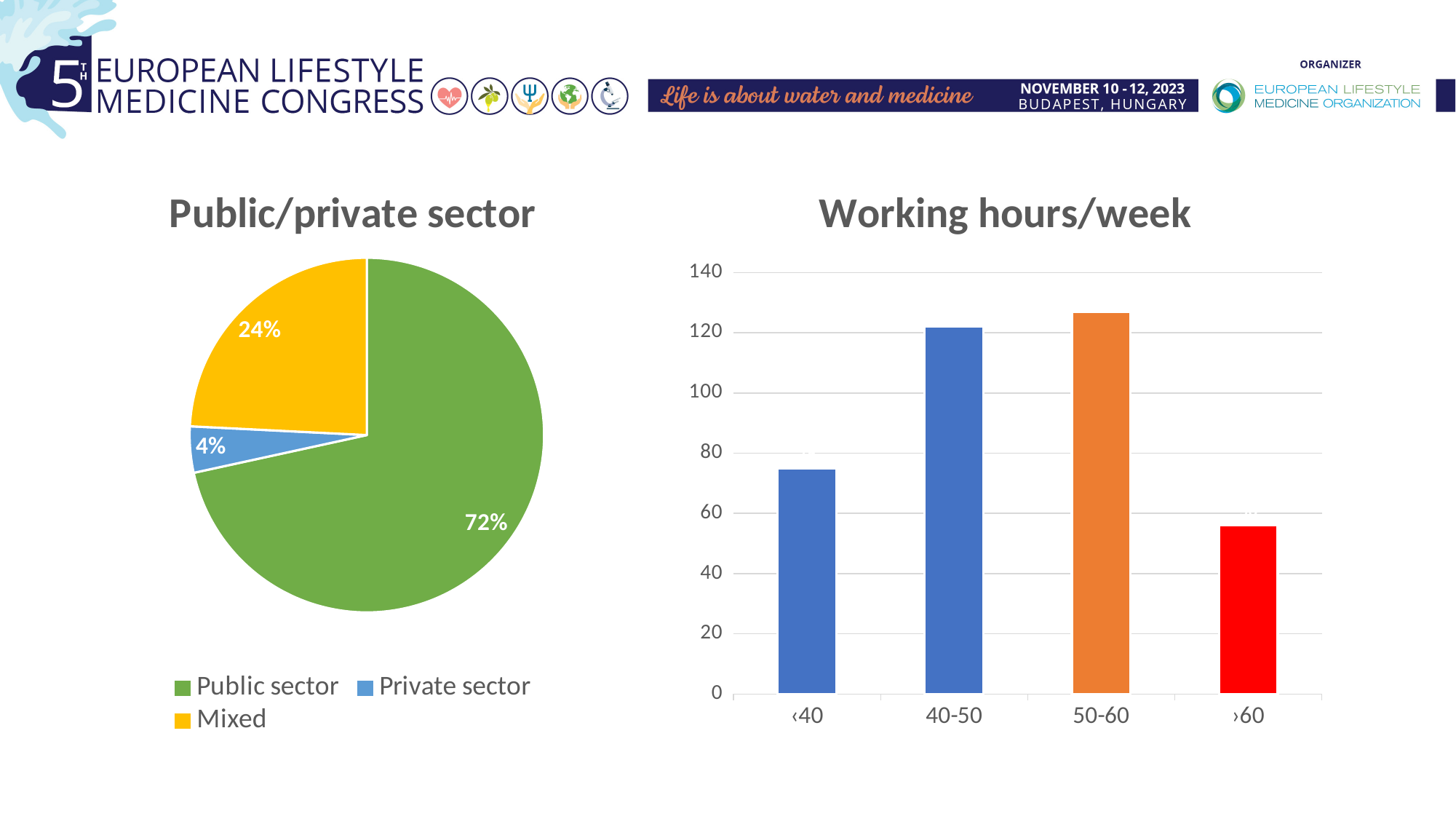
In the Working hours/week chart, is the value for 40-50 greater or less than 100? greater In the Working hours/week chart, which category has the lowest bar? >60 In the Public/private sector chart, what share of the pie is the Private sector? 4% In the Public/private sector chart, which category has the largest slice? Public sector How many categories are shown on the x axis of the Working hours/week chart? 4 What kind of chart is the Working hours/week chart? Bar chart In the Working hours/week chart, is the value for <40 greater or less than 80? less In the Public/private sector chart, what share of the pie is Mixed? 24% In the Public/private sector chart, what is the difference in percentage points between the Mixed and Private sector slices? 20 What kind of chart is the Public/private sector chart? Pie chart In the Public/private sector chart, what share of the pie is the Public sector? 72% In the Public/private sector chart, which category has the smallest slice? Private sector